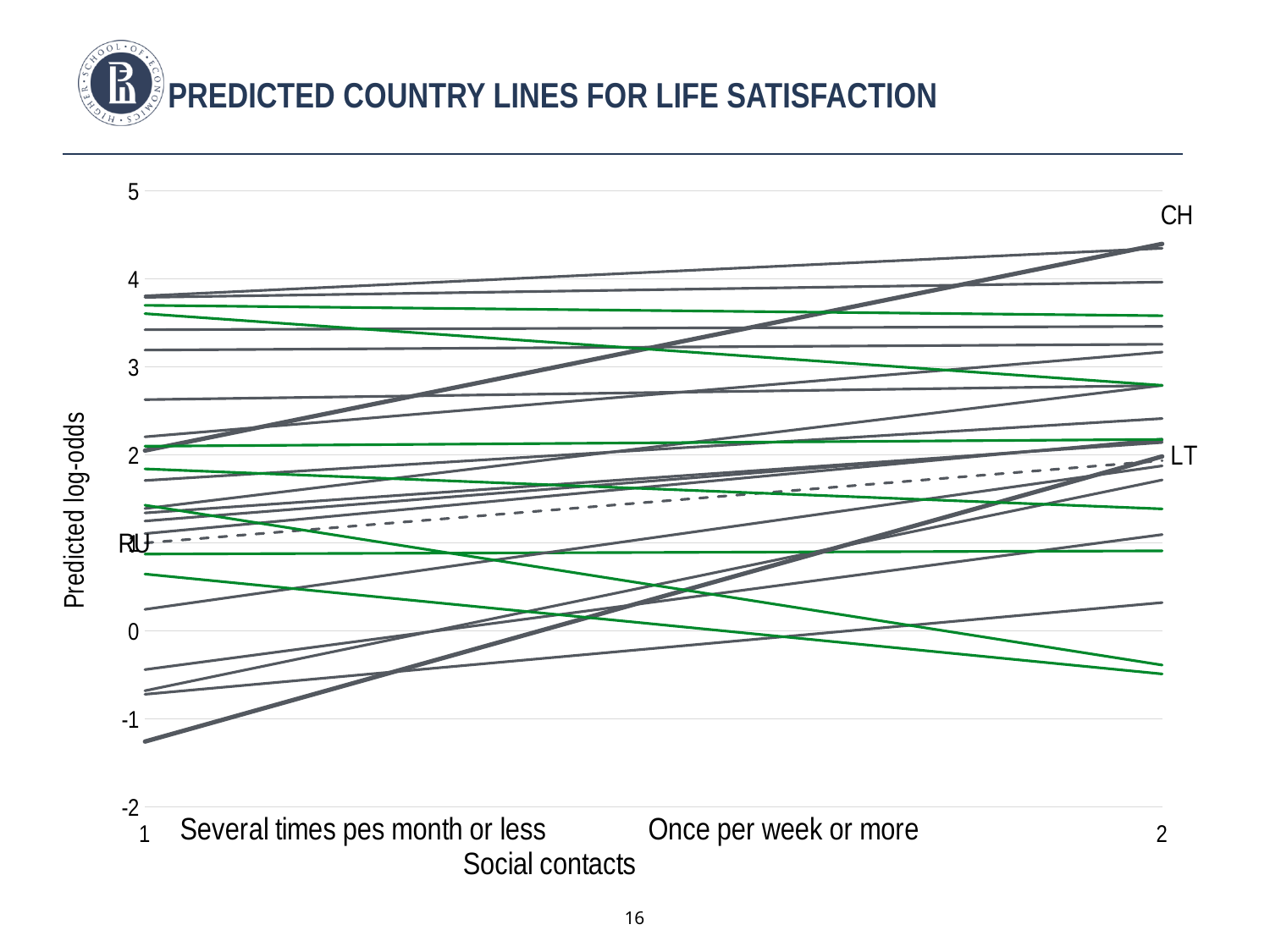
What kind of chart is shown on the slide? Line chart How many social-contact categories are shown along the x axis? 2 Is the value for CH at 'Several times pes month or less' greater or less than 3? less At 'Once per week or more', which labelled country has the higher predicted log-odds, CH or LT? CH Does the line labelled CH rise or fall from 'Several times pes month or less' to 'Once per week or more'? Rises Which labelled country line has the highest predicted log-odds at 'Once per week or more'? CH Is the value for CH at 'Once per week or more' greater or less than 4? greater Does the dashed line labelled RU rise or fall from 'Several times pes month or less' to 'Once per week or more'? Rises Is the value for LT at 'Several times pes month or less' greater or less than 0? less What is the title of the chart on the slide? PREDICTED COUNTRY LINES FOR LIFE SATISFACTION What is the label of the vertical axis? Predicted log-odds